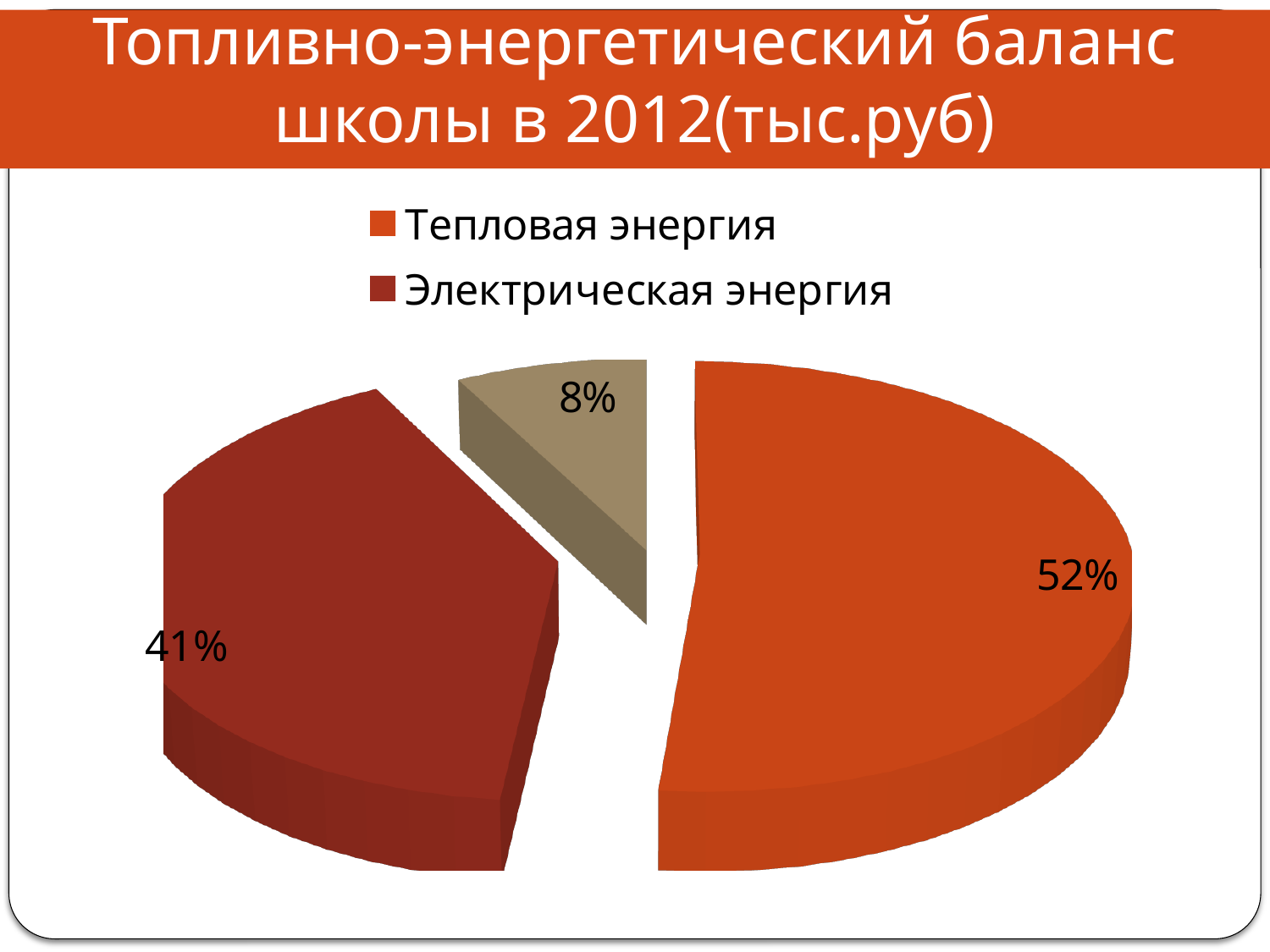
What kind of chart is shown on the slide? pie chart What is the smallest percentage labelled on the pie chart? 8% What is the title of the slide containing the chart? Топливно-энергетический баланс школы в 2012(тыс.руб) Which category has the largest slice of the pie? Тепловая энергия What colour is the slice for Электрическая энергия? dark red What share of the pie does Тепловая энергия take? 52% Which is larger, the slice for Тепловая энергия or the slice for Электрическая энергия? Тепловая энергия What is the difference in percentage points between the Тепловая энергия slice and the Электрическая энергия slice? 11 How many entries does the legend list? 2 How many slices does the pie chart have? 3 What share of the pie does Электрическая энергия take? 41%